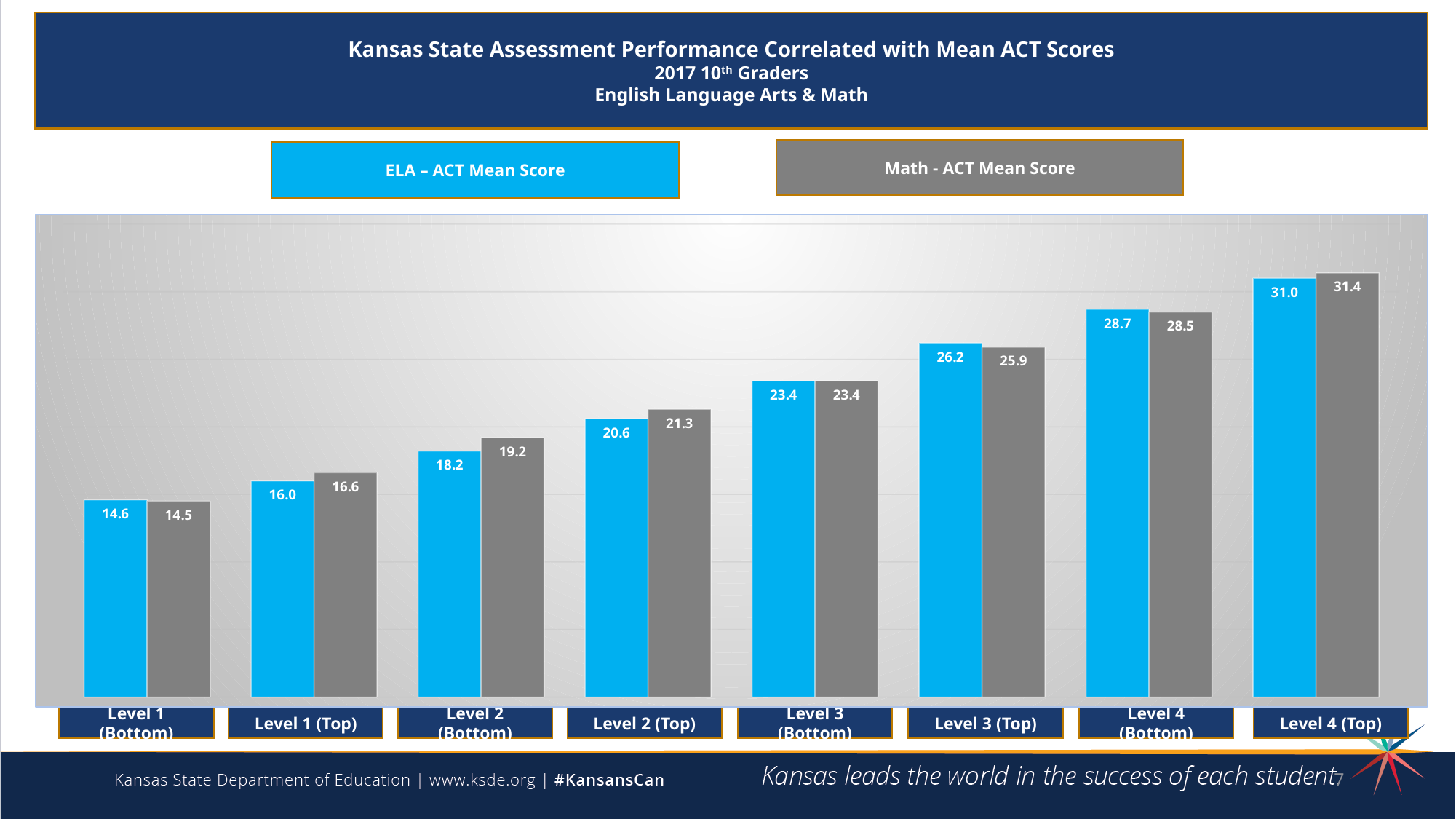
What kind of chart is shown on the slide? Bar chart Which category has the highest ELA – ACT Mean Score? Level 4 (Top) Do the ELA – ACT Mean Scores rise or fall from Level 1 (Bottom) to Level 4 (Top)? Rise Which category has the lowest Math - ACT Mean Score? Level 1 (Bottom) For Level 3 (Top), which is larger: the ELA – ACT Mean Score or the Math - ACT Mean Score? ELA – ACT Mean Score What is the difference between the ELA – ACT Mean Score for Level 4 (Top) and for Level 1 (Bottom)? 16.4 What is the Math - ACT Mean Score for Level 3 (Bottom)? 23.4 What is the Math - ACT Mean Score for Level 1 (Top)? 16.6 How many categories are shown on the x axis? 8 What is the ELA – ACT Mean Score for Level 2 (Top)? 20.6 How many series does the legend list? 2 What is the difference between the Math - ACT Mean Score and the ELA – ACT Mean Score for Level 2 (Bottom)? 1.0